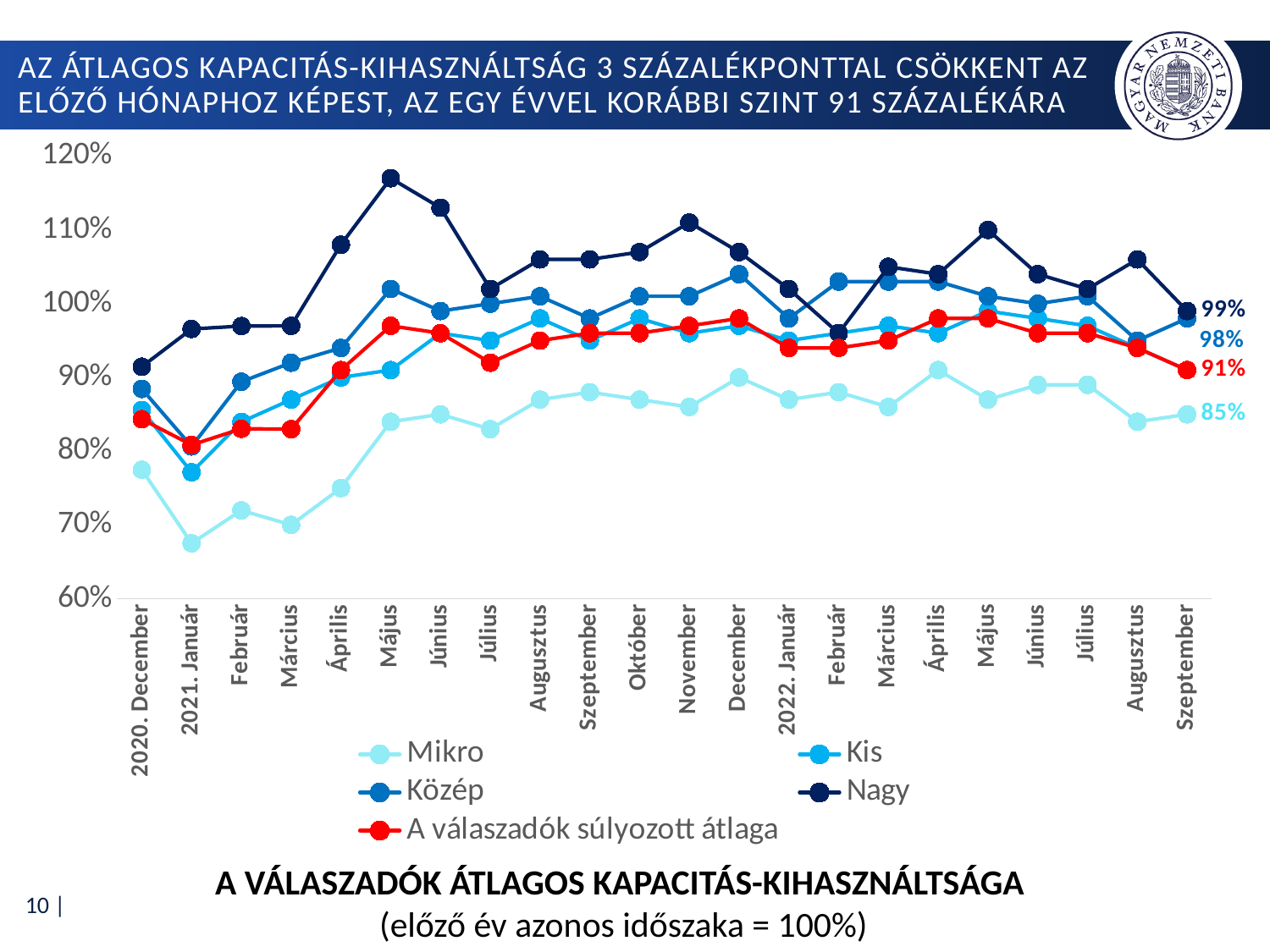
Which series has the lowest value in 2021 Január? Mikro What is the difference between the Nagy and Mikro values in 2022 Szeptember? 14 percentage points How many series does the legend list? 5 Which series has the highest value in 2021 Május? Nagy What is the title of the chart? A válaszadók átlagos kapacitás-kihasználtsága (előző év azonos időszaka = 100%) What is the value for A válaszadók súlyozott átlaga in 2022 Szeptember? 91% How many months are shown on the x axis? 22 What is the value for Nagy in 2022 Szeptember? 99% Is the value for Nagy in 2021 Május greater or less than 110%? greater What kind of chart is shown on the slide? line chart What is the value for Mikro in 2022 Szeptember? 85% Is the value for Mikro in 2021 Január greater or less than 70%? less